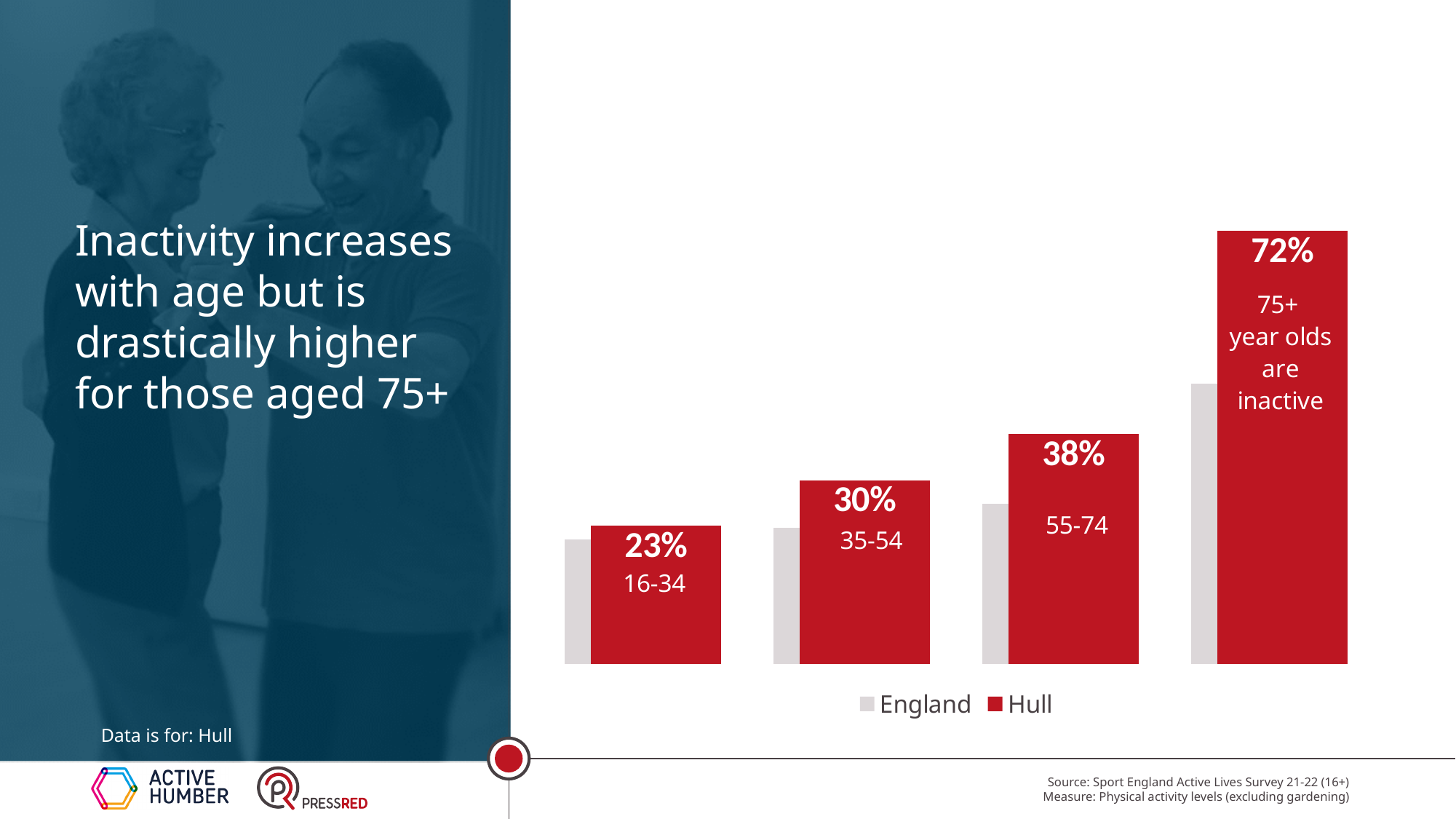
For the 75+ age group, which is larger: the Hull value or the England value? Hull What is the Hull inactivity value for the 35-54 age group? 30% Which age group has the highest Hull inactivity value? 75+ What is the Hull inactivity value for the 55-74 age group? 38% How many series does the legend list? 2 What is the Hull inactivity value for the 75+ age group? 72% What is the difference between the Hull values for the 75+ and 55-74 age groups? 34 percentage points What is the difference between the Hull values for the 35-54 and 16-34 age groups? 7 percentage points How many age groups are shown on the chart? 4 Do the Hull inactivity values rise or fall as age increases across the chart? rise Which age group has the lowest Hull inactivity value? 16-34 What is the Hull inactivity value for the 16-34 age group? 23%